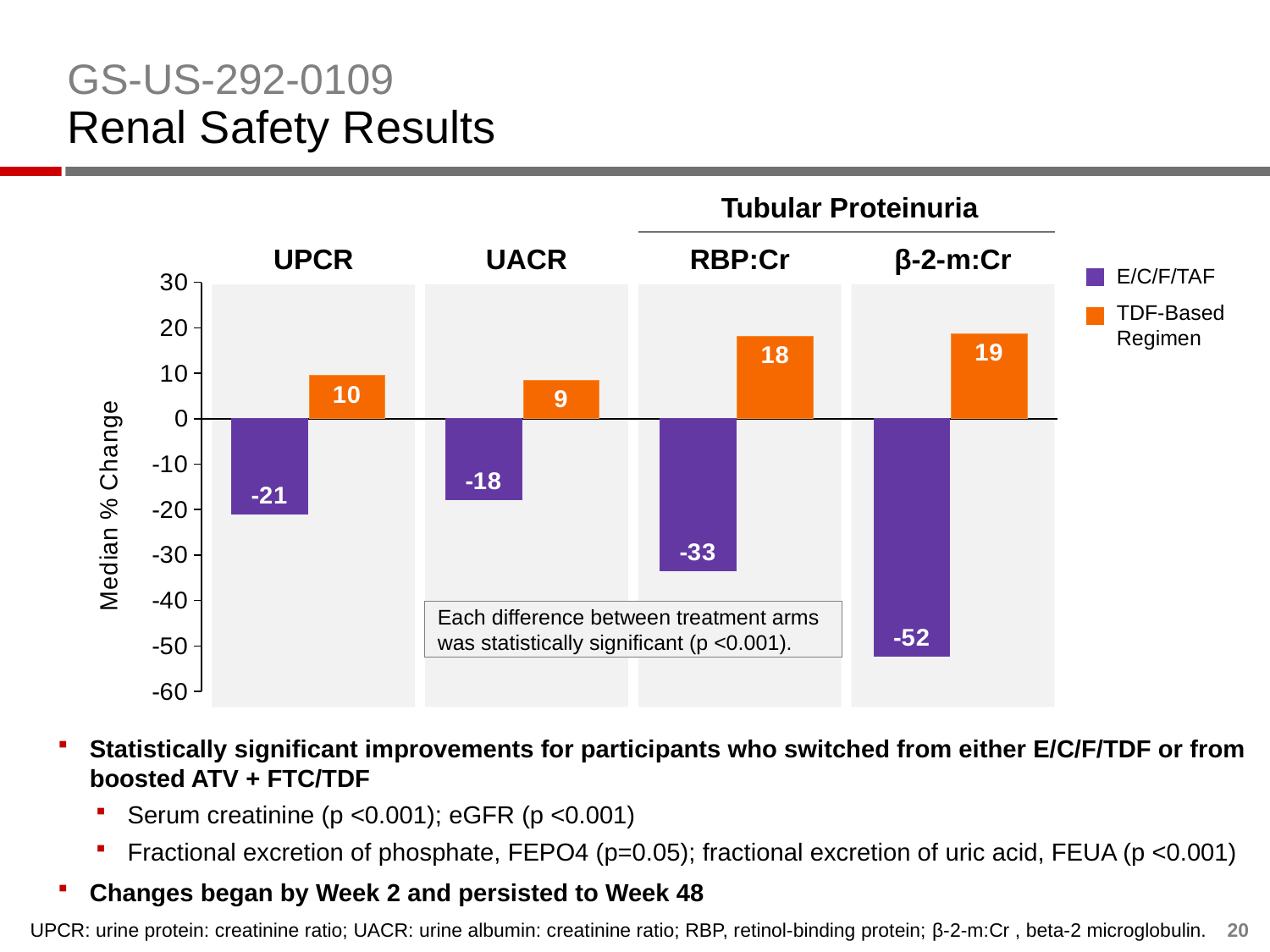
For which category does E/C/F/TAF show the largest decrease in median % change? β-2-m:Cr How many series does the legend list? 2 What is the label of the y axis? Median % Change What is the median % change in RBP:Cr for the TDF-Based Regimen? 18 What kind of chart is shown on the slide? Bar chart What is the difference between the TDF-Based Regimen and E/C/F/TAF median % change for RBP:Cr? 51 What is the median % change in UPCR for E/C/F/TAF? -21 For which category does the TDF-Based Regimen show the smallest median % change? UACR What is the median % change in UACR for the TDF-Based Regimen? 9 What is the median % change in β-2-m:Cr for E/C/F/TAF? -52 How many categories are shown on the x axis of the chart? 4 Which has a larger decrease in median % change for E/C/F/TAF: UPCR or UACR? UPCR